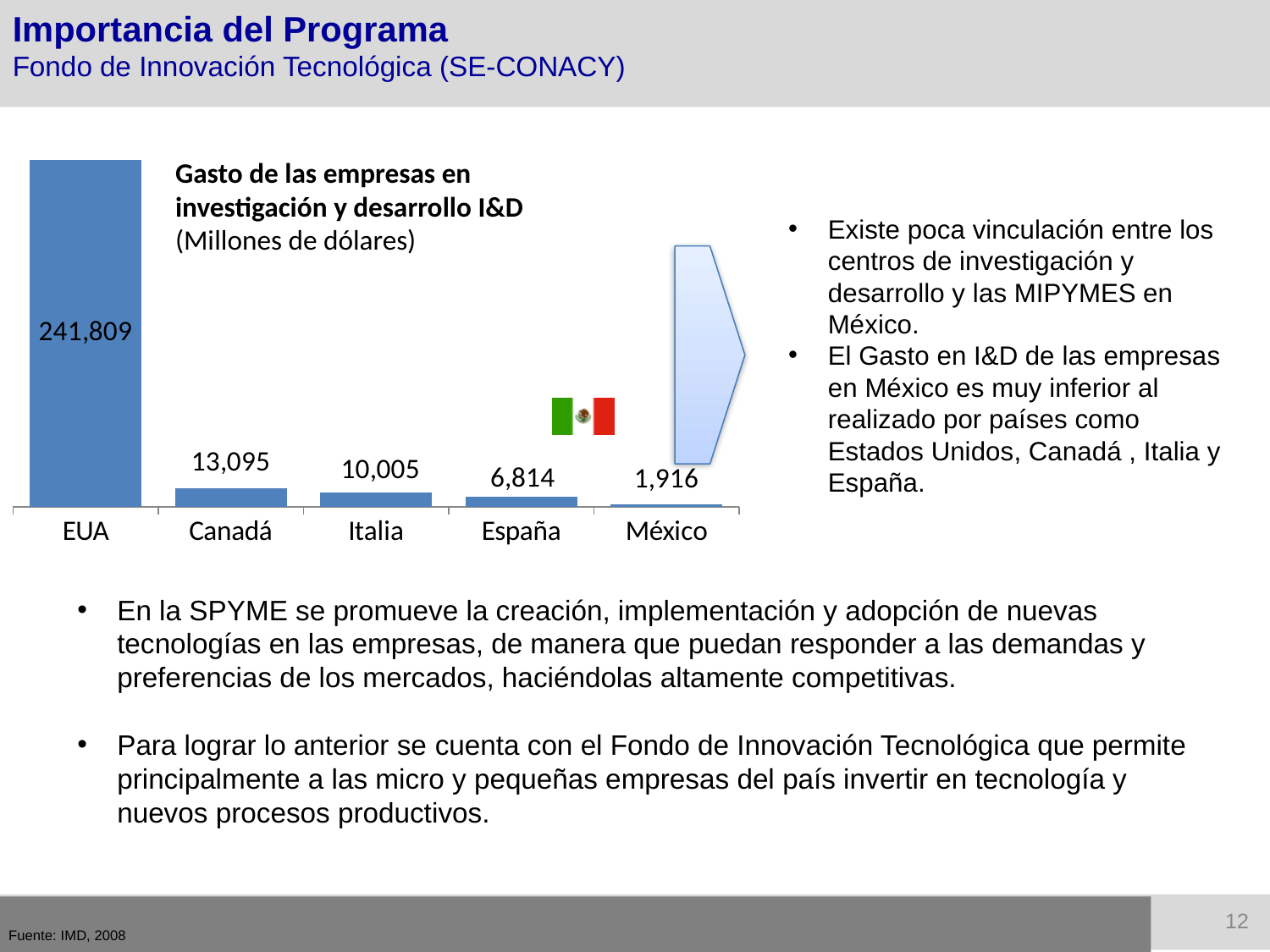
Which country has the lowest value in the chart? México What is the value for Canadá in the chart? 13,095 What is the value for España in the chart? 6,814 What kind of chart is shown on the slide? Bar chart Which country has the highest value in the chart? EUA What is the value for Italia in the chart? 10,005 What is the difference between the values for Canadá and Italia? 3,090 What is the value for México in the chart? 1,916 What is the value for EUA in the chart? 241,809 Which is larger, the value for Italia or the value for España? Italia What is the difference between the values for España and México? 4,898 How many countries are shown in the chart? 5